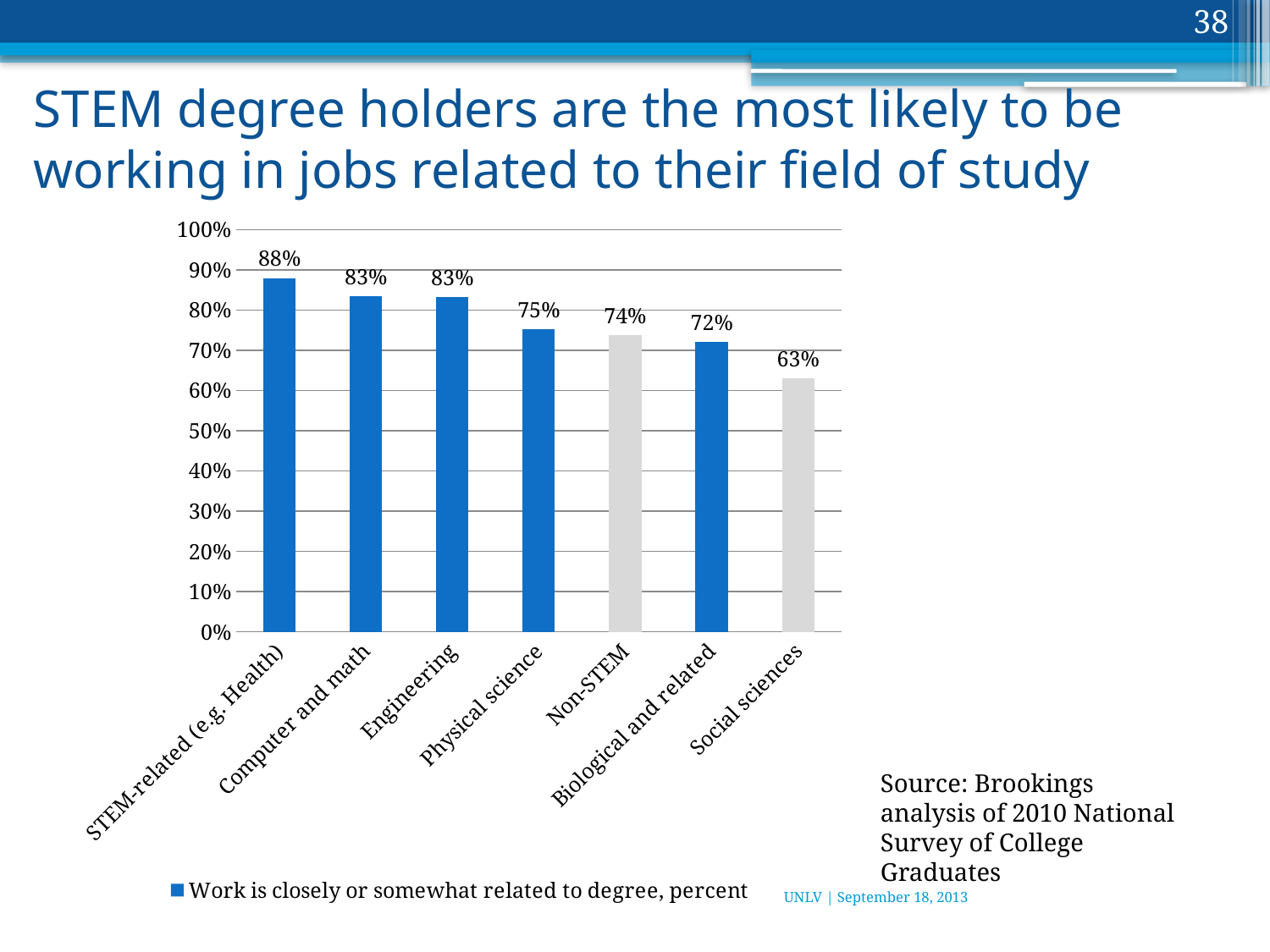
What is the value for Social sciences? 63% Which category has the highest value? STEM-related (e.g. Health) What is the difference between the values for STEM-related (e.g. Health) and Social sciences? 25% What kind of chart is shown on the slide? bar chart What is the value for Non-STEM? 74% What is the value for Physical science? 75% What is the value for STEM-related (e.g. Health)? 88% What is the difference between the values for Engineering and Biological and related? 11% How many categories are shown on the x axis? 7 What series does the legend list? Work is closely or somewhat related to degree, percent Which category has the lowest value? Social sciences Which is larger, the value for Non-STEM or the value for Biological and related? Non-STEM